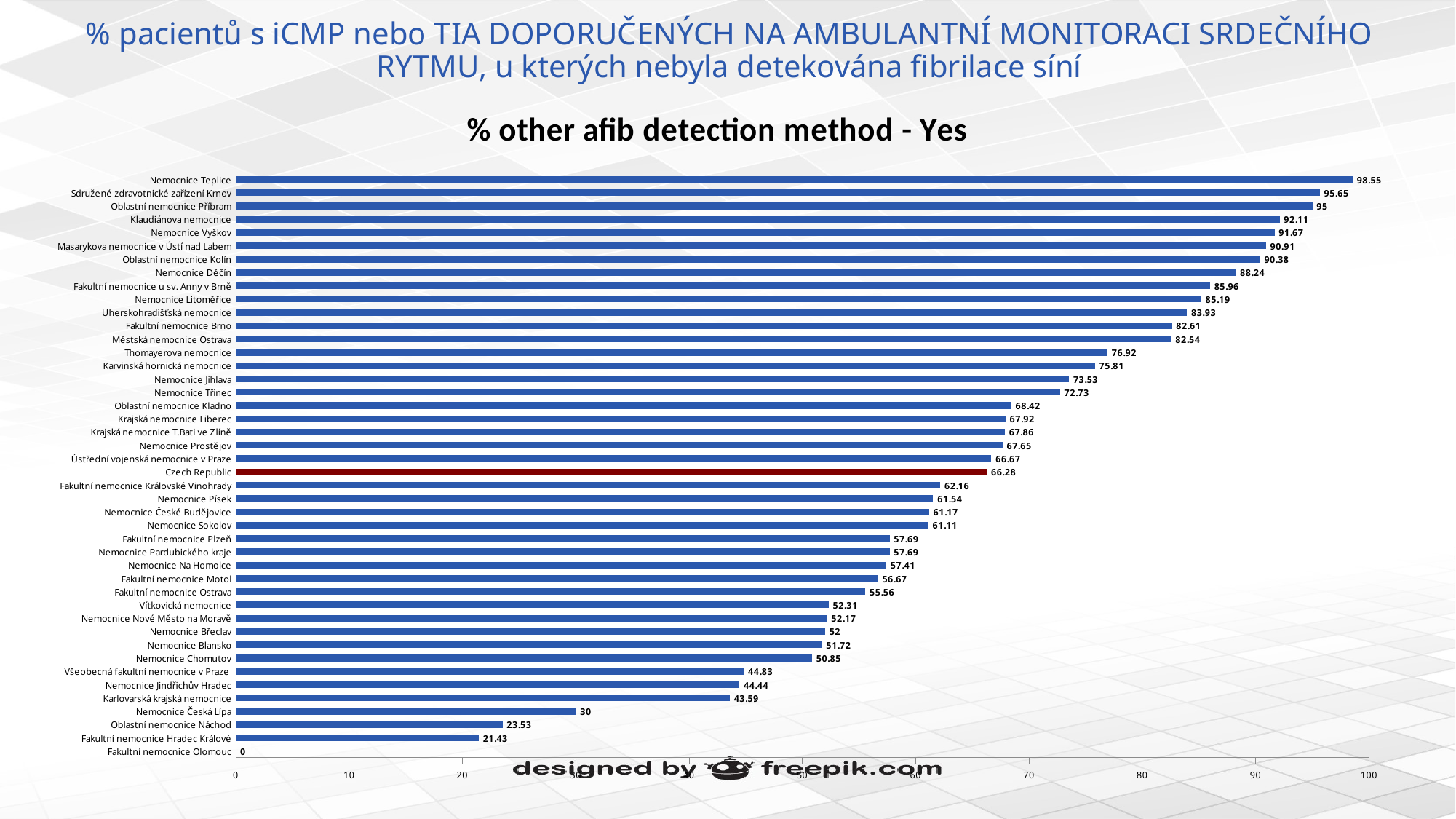
What is the value for Czech Republic? 66.28 Is the value for Nemocnice Česká Lípa greater or less than 40? less What is the title of the chart? % other afib detection method - Yes Which category has the lowest value? Fakultní nemocnice Olomouc What kind of chart is shown? bar chart What is the value for Nemocnice Teplice? 98.55 What is the value for Fakultní nemocnice Motol? 56.67 Which category has the highest value? Nemocnice Teplice How many categories are plotted on the chart? 44 Which is larger, the value for Nemocnice Jihlava or the value for Nemocnice Chomutov? Nemocnice Jihlava What is the difference between the values for Nemocnice Teplice and Czech Republic? 32.27 Which category's bar is coloured differently (dark red) from the others? Czech Republic